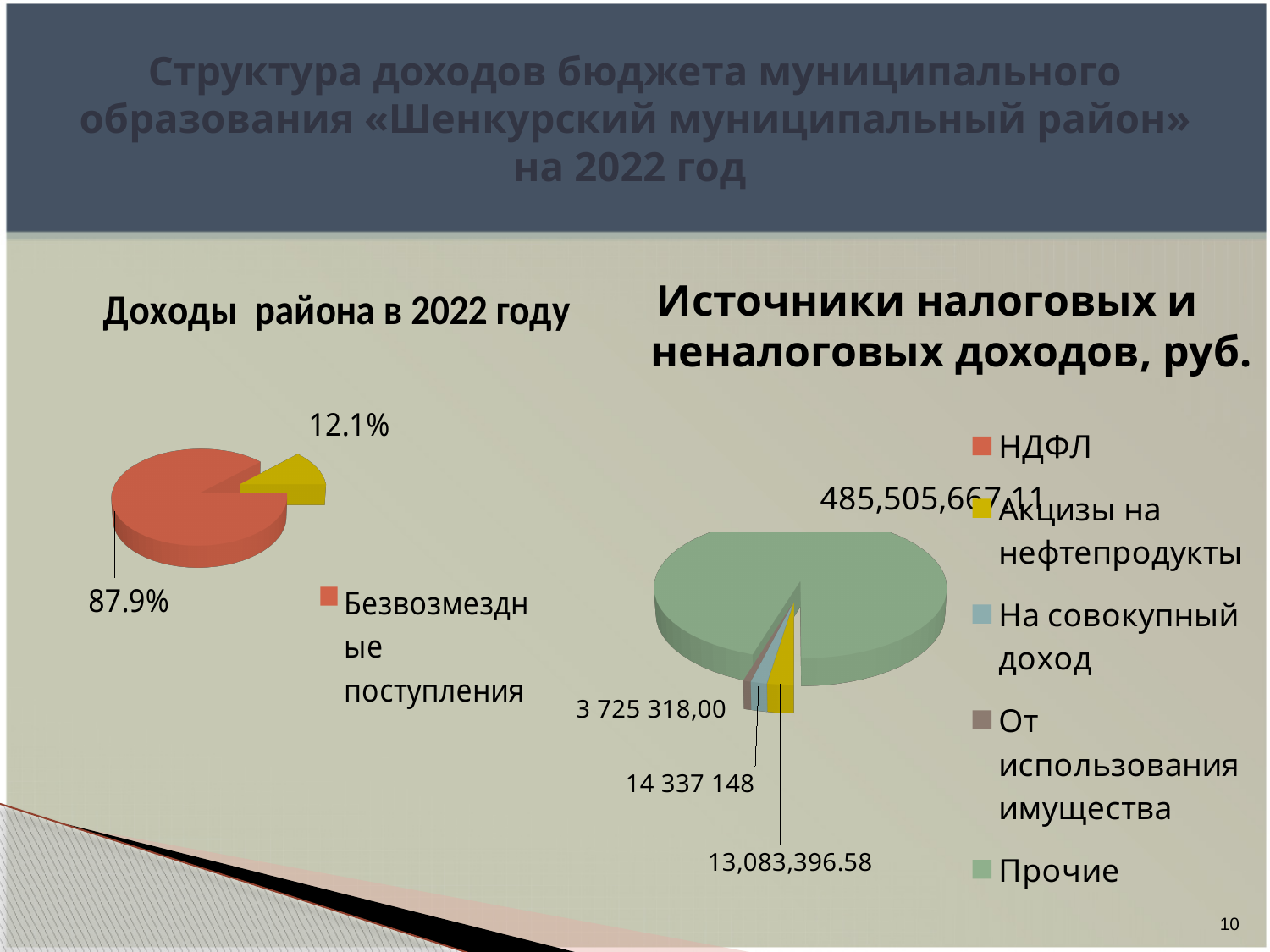
In the left chart "Доходы района в 2022 году", what is the share of the smaller slice? 12.1% In the right chart "Источники налоговых и неналоговых доходов, руб.", what is the value for Акцизы на нефтепродукты? 13,083,396.58 In the right chart "Источники налоговых и неналоговых доходов, руб.", which is larger: На совокупный доход or Акцизы на нефтепродукты? На совокупный доход In the right chart "Источники налоговых и неналоговых доходов, руб.", what is the largest value labelled on the chart? 485,505,667.11 What kind of chart is the left chart titled "Доходы района в 2022 году"? pie chart In the left chart "Доходы района в 2022 году", what share is shown for Безвозмездные поступления? 87.9% How many entries does the legend of the right chart "Источники налоговых и неналоговых доходов, руб." list? 5 In the right chart "Источники налоговых и неналоговых доходов, руб.", what is the value for На совокупный доход? 14 337 148 In the left chart "Доходы района в 2022 году", what colour is the slice for Безвозмездные поступления? red In the right chart "Источники налоговых и неналоговых доходов, руб.", what is the value for От использования имущества? 3 725 318,00 How many slices does the left chart "Доходы района в 2022 году" have? 2 In the right chart "Источники налоговых и неналоговых доходов, руб.", which labelled category has the smallest value? От использования имущества